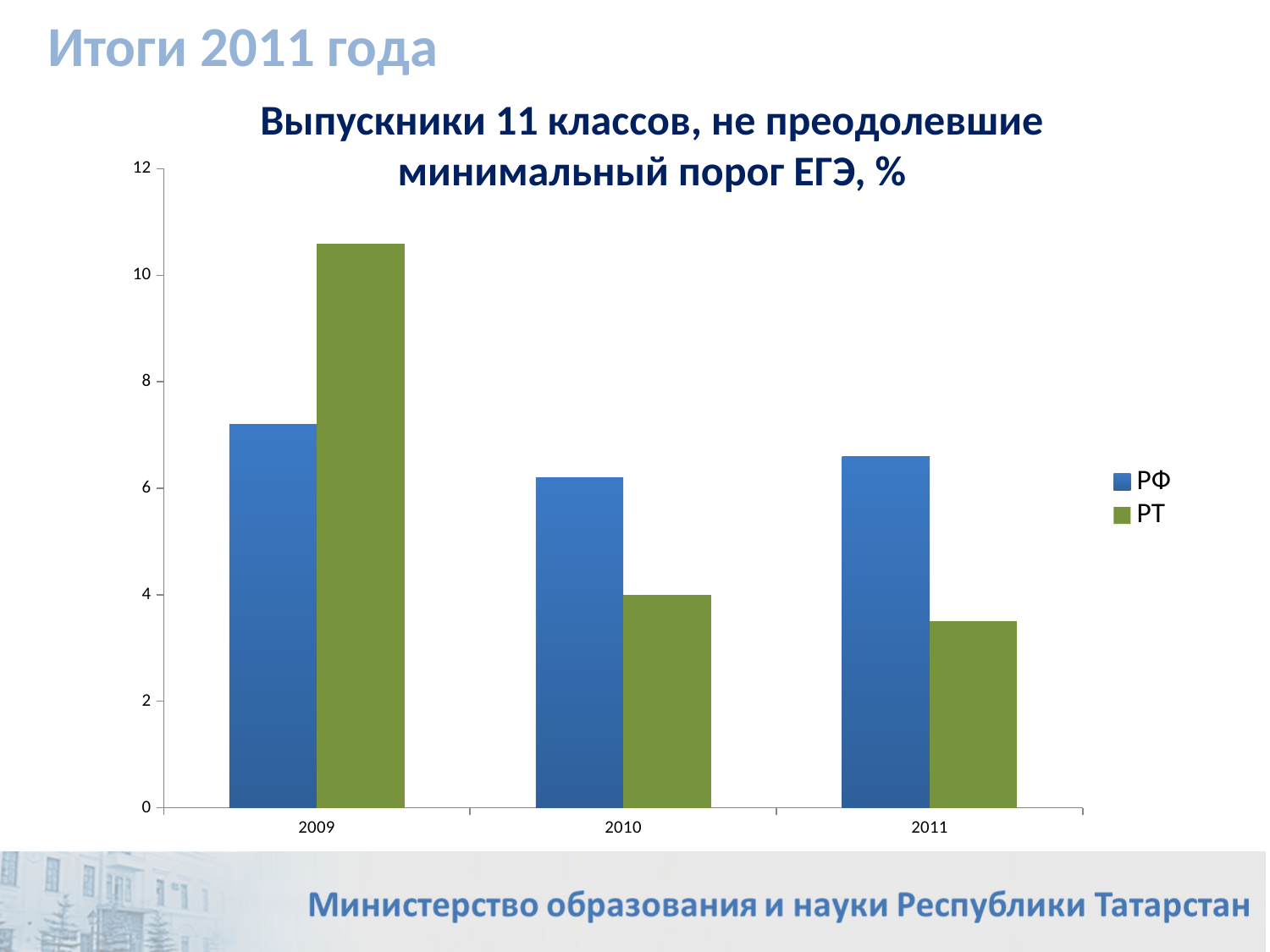
In which year is the value for РФ highest? 2009 How many series does the legend list? 2 In 2009, which is larger, РФ or РТ? РТ Which series is shown in green in the legend? РТ Is the value for РТ in 2011 greater or less than 4? less In which year is the value for РТ lowest? 2011 Do the values for РТ rise or fall from 2009 to 2011? fall In which year is the value for РТ highest? 2009 How many years are shown on the x axis? 3 What kind of chart is shown on the slide? bar chart Is the value for РТ in 2009 greater or less than 10? greater In 2011, which is larger, РФ or РТ? РФ